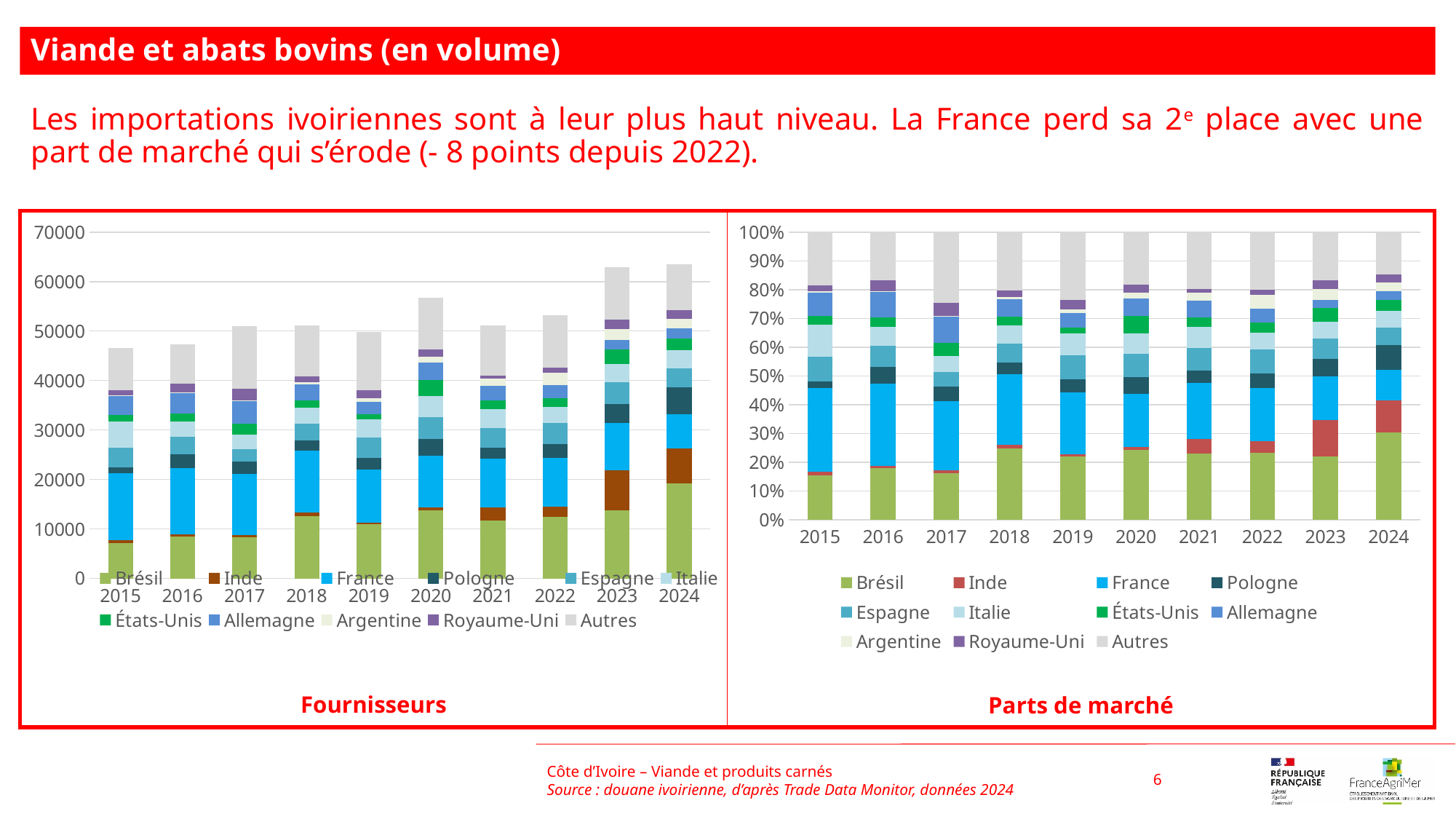
What is the title shown under the right-hand chart? Parts de marché In the 'Fournisseurs' chart, which is larger: the total bar for 2024 or the total bar for 2015? 2024 In the 'Fournisseurs' chart, do the total bars generally rise or fall from 2015 to 2024? Rise How many series does the legend of the 'Fournisseurs' chart list? 11 In the 'Fournisseurs' chart, is the total bar for 2015 greater or less than 50000? less In the 'Parts de marché' chart, is the share of France in 2024 greater or less than 20%? less In the 'Fournisseurs' chart, is the total bar for 2020 greater or less than 50000? greater What kind of chart is the 'Fournisseurs' chart on the left? Stacked bar chart How many years are shown on the x axis of the 'Parts de marché' chart? 10 Which series is plotted at the bottom of each stacked bar in the 'Parts de marché' chart? Brésil